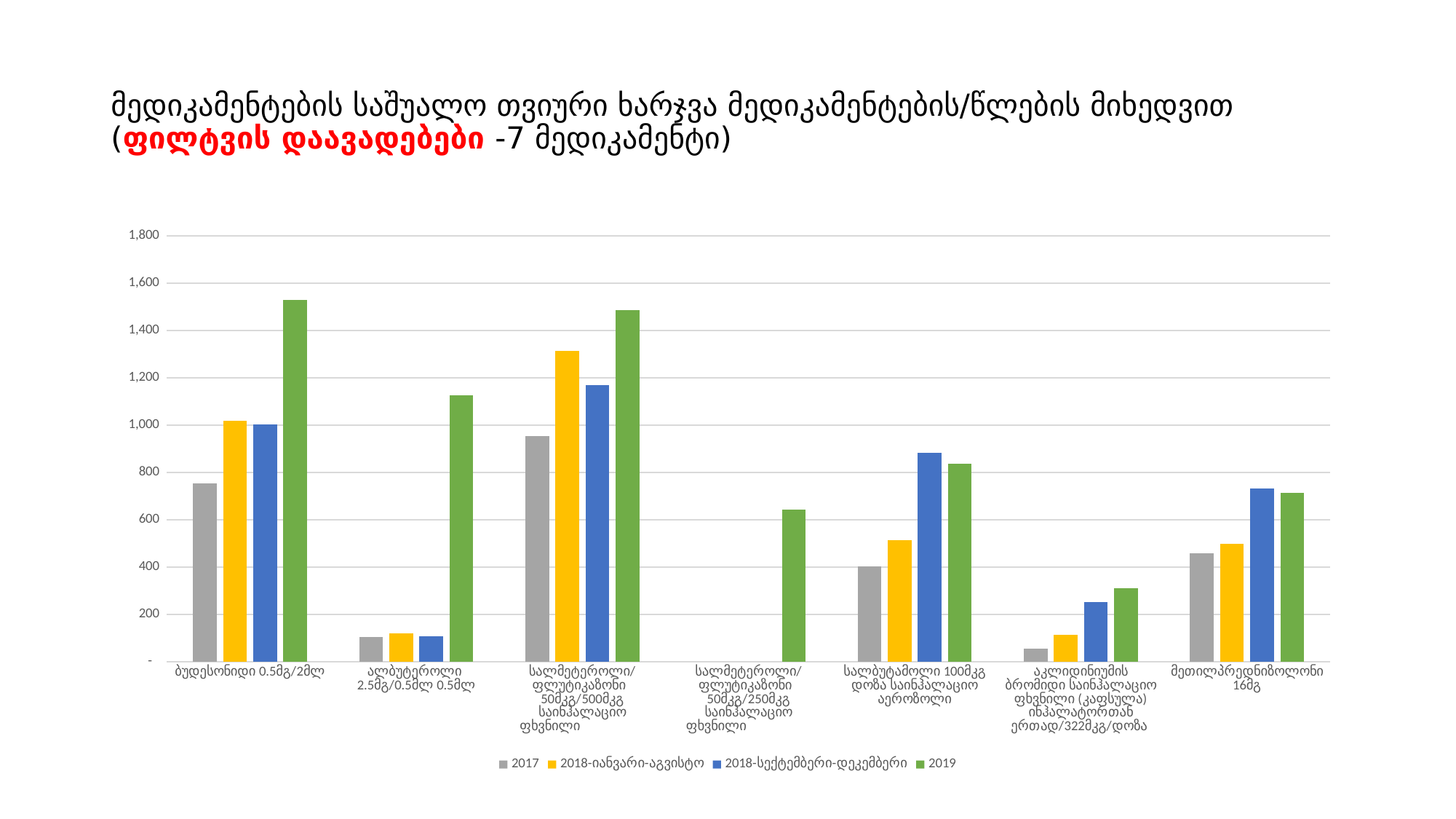
For სალმეტეროლი/ფლუტიკაზონი 50მკგ/500მკგ საინჰალაციო ფხვნილი, which is larger: the 2018-იანვარი-აგვისტო value or the 2018-სექტემბერი-დეკემბერი value? 2018-იანვარი-აგვისტო Which series is shown in grey in the legend? 2017 Which category has the highest 2019 value? ბუდესონიდი 0.5მგ/2მლ Which category has the lowest 2017 value? აკლიდინიუმის ბრომიდი საინჰალაციო ფხვნილი (კაფსულა) ინჰალატორთან ერთად/322მკგ/დოზა Which series is shown in green in the legend? 2019 Is the 2017 value for ალბუტეროლი 2.5მგ/0.5მლ 0.5მლ greater or less than 200? less What kind of chart is shown on the slide? bar chart How many medication categories are shown along the x axis? 7 How many series does the legend list? 4 Is the 2019 value for ბუდესონიდი 0.5მგ/2მლ greater or less than 1,400? greater Is the 2019 value for სალმეტეროლი/ფლუტიკაზონი 50მკგ/250მკგ საინჰალაციო ფხვნილი greater or less than 600? greater For აკლიდინიუმის ბრომიდი საინჰალაციო ფხვნილი (კაფსულა) ინჰალატორთან ერთად/322მკგ/დოზა, do the values rise or fall from the 2017 series to the 2019 series? rise